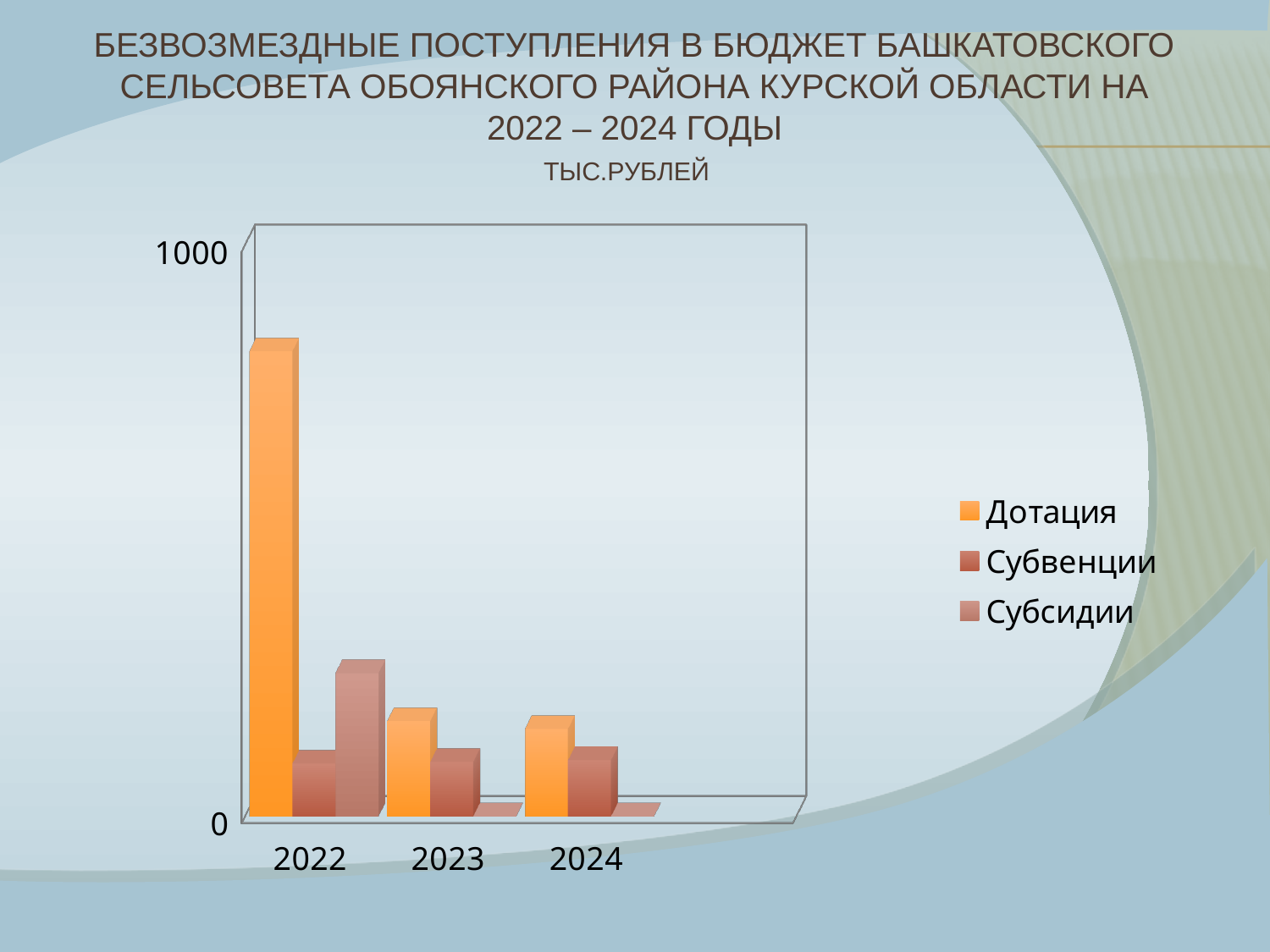
In what units are the values of the chart given, according to the subtitle? тыс.рублей What kind of chart is shown on the slide? bar chart Which series has the highest bar in the chart? Дотация Which is larger in 2022: Субвенции or Субсидии? Субсидии How many series does the chart's legend list? 3 Which is larger: Дотация in 2022 or Дотация in 2023? Дотация in 2022 How many years are shown on the x axis of the chart? 3 Does the Субсидии value rise or fall from 2022 to 2024? fall Does the Дотация value rise or fall from 2022 to 2024? fall Is the value for Дотация in 2022 greater or less than 1000? less In which year is the Дотация bar the highest? 2022